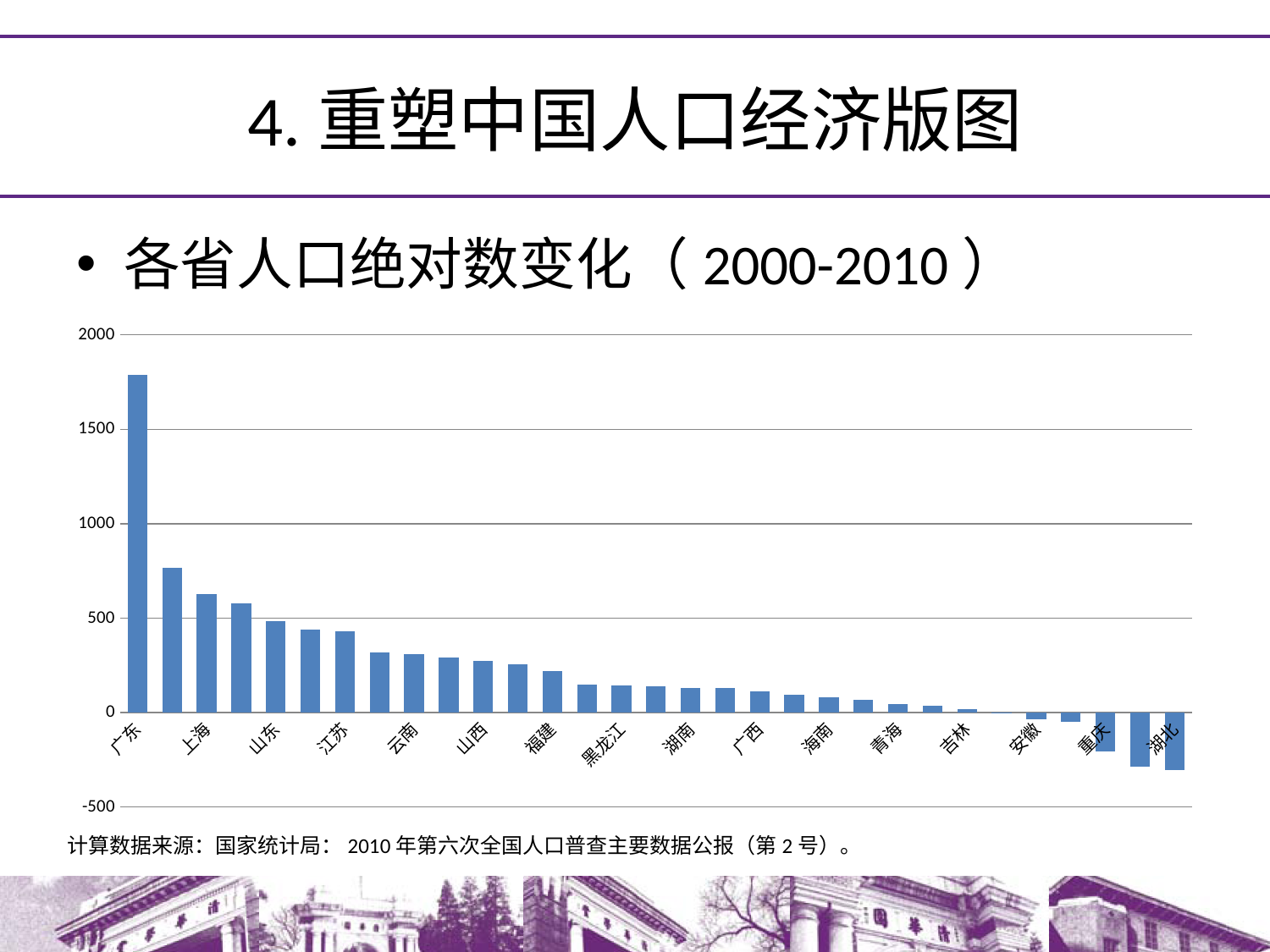
Is the value for 湖北 greater or less than 0? less Is the value for 重庆 greater or less than 0? less Which has the larger value, 福建 or 广西? 福建 Which province has the highest value in the chart? 广东 Is the value for 上海 greater or less than 500? greater Which has the larger value, 上海 or 山东? 上海 What kind of chart is shown on the slide? bar chart What is the highest value shown on the vertical axis? 2000 How many bars are plotted in the chart? 31 Do the values rise or fall from left to right along the x axis? fall